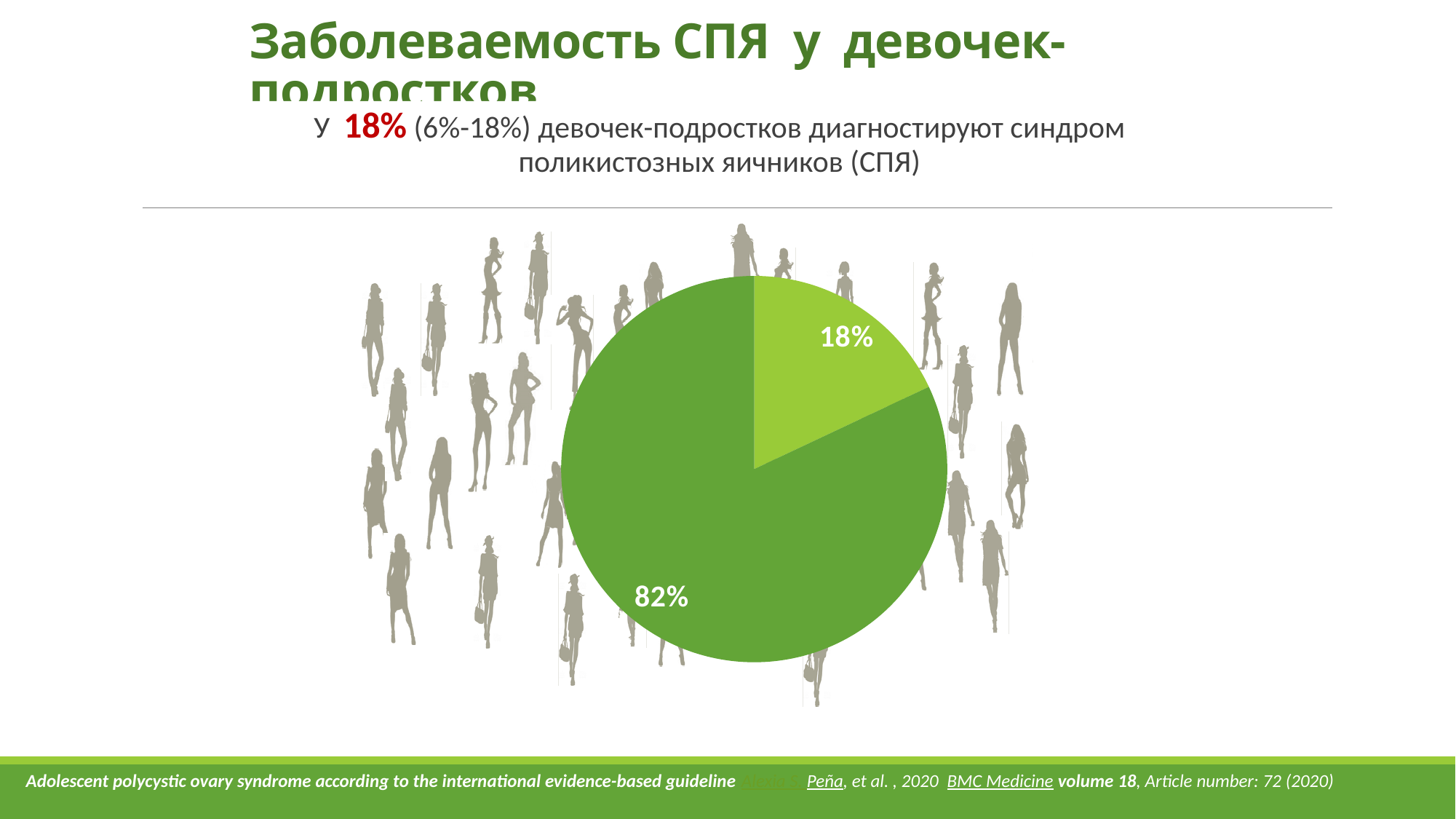
According to the slide text, what percentage of adolescent girls are diagnosed with polycystic ovary syndrome (СПЯ)? 18% What is the largest slice value in the pie chart? 82% What value is labelled on the dark green slice of the pie chart? 82% How many slices does the pie chart have? 2 What is the smallest slice value in the pie chart? 18% What share of the pie does the light green slice represent? 18% Which slice is larger in the pie chart, the light green one or the dark green one? the dark green one What is the difference between the two slice values in the pie chart? 64% What value is labelled on the light green slice of the pie chart? 18% What colour is the 82% slice of the pie chart? dark green What kind of chart is shown on the slide? pie chart What do the two slices of the pie chart add up to? 100%